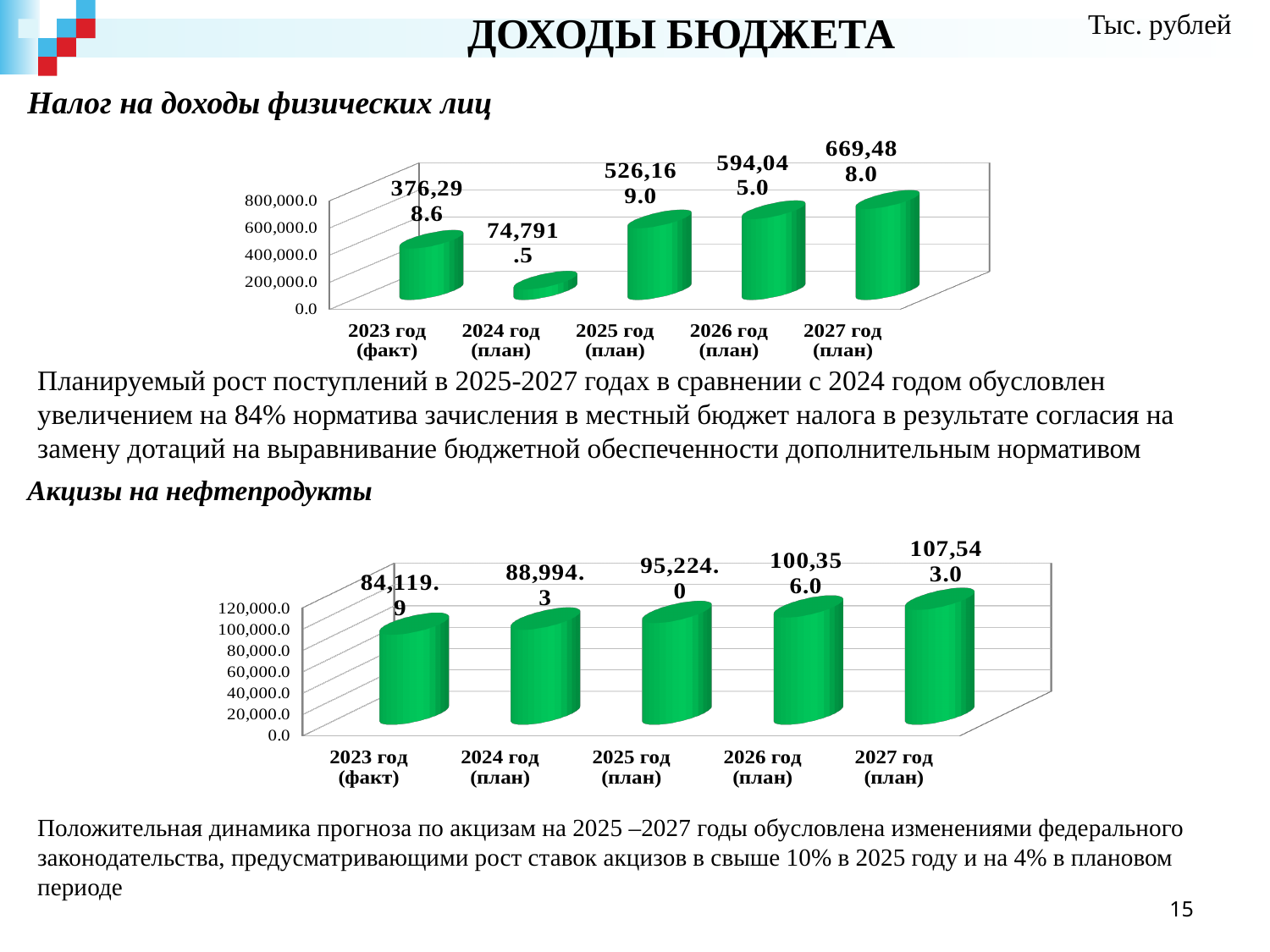
In the 'Налог на доходы физических лиц' chart, what is the value for 2027 год (план)? 669,488.0 In the 'Налог на доходы физических лиц' chart, is the value for 2023 год (факт) greater or less than 200,000.0? greater In the 'Налог на доходы физических лиц' chart, what is the difference between the 2027 год (план) value and the 2024 год (план) value? 594,696.5 In the 'Акцизы на нефтепродукты' chart, do the values rise or fall from 2023 to 2027? rise In the 'Налог на доходы физических лиц' chart, what is the value for 2024 год (план)? 74,791.5 In the 'Акцизы на нефтепродукты' chart, what is the difference between the 2027 год (план) value and the 2023 год (факт) value? 23,423.1 In the 'Акцизы на нефтепродукты' chart, which is larger: the value for 2026 год (план) or the value for 2024 год (план)? 2026 год (план) In the 'Налог на доходы физических лиц' chart, which year has the highest value? 2027 год (план) In the 'Налог на доходы физических лиц' chart, which year has the lowest value? 2024 год (план) In the 'Акцизы на нефтепродукты' chart, what is the value for 2025 год (план)? 95,224.0 How many categories (years) are shown in the 'Акцизы на нефтепродукты' chart? 5 In the 'Акцизы на нефтепродукты' chart, what is the value for 2023 год (факт)? 84,119.9